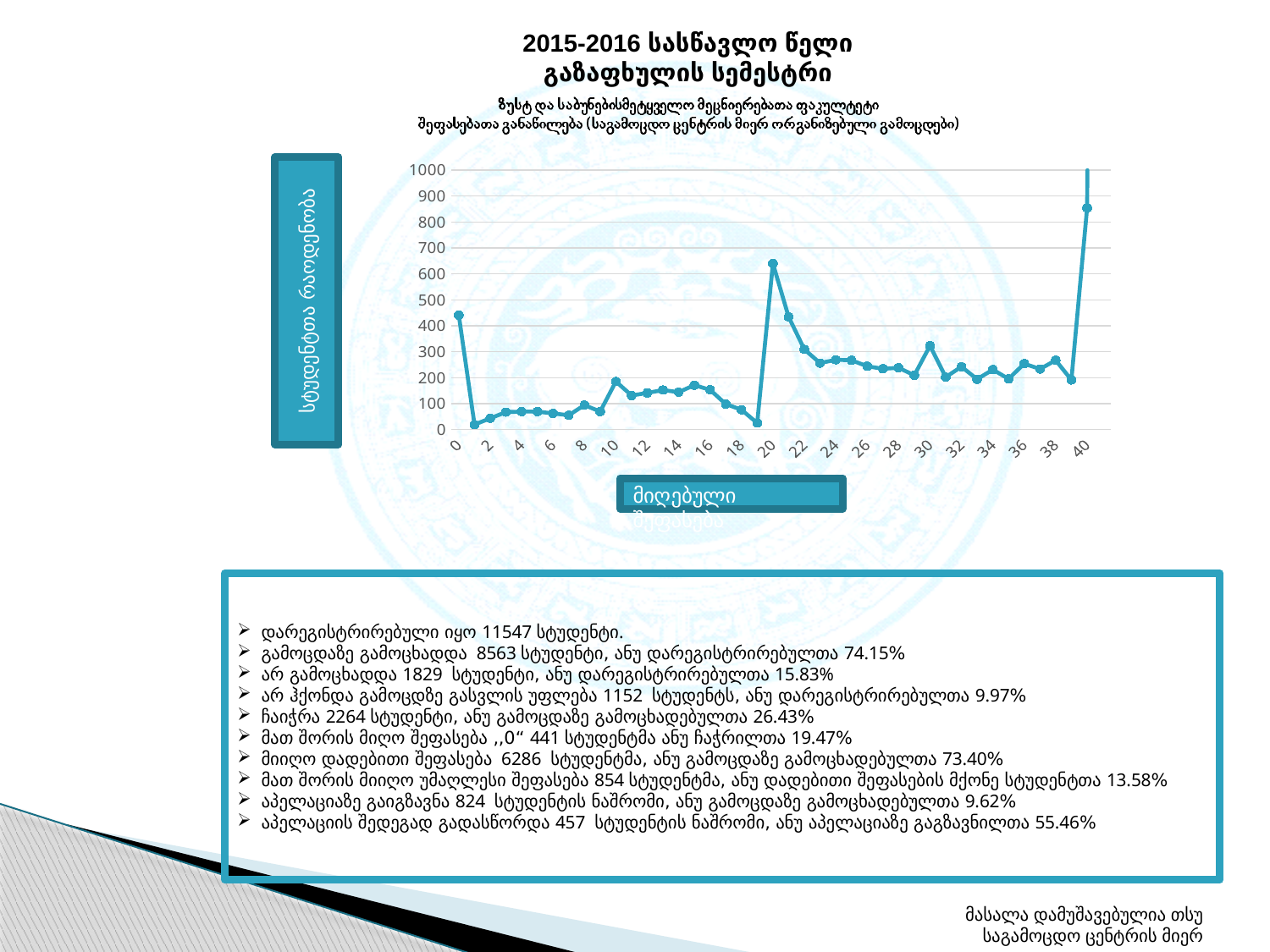
Which has the larger value, score 40 or score 20? score 40 What kind of chart is shown on the slide? line chart Do the values rise or fall between score 20 and score 24? fall Is the value at score 20 greater or less than 500? greater Which has the larger value, score 20 or score 0? score 20 Is the value at score 5 greater or less than 200? less Is the value at score 40 greater or less than 800? greater What is the label below the horizontal axis of the chart? მიღებული შეფასება What is the label on the vertical axis of the chart? სტუდენტთა რაოდენობა